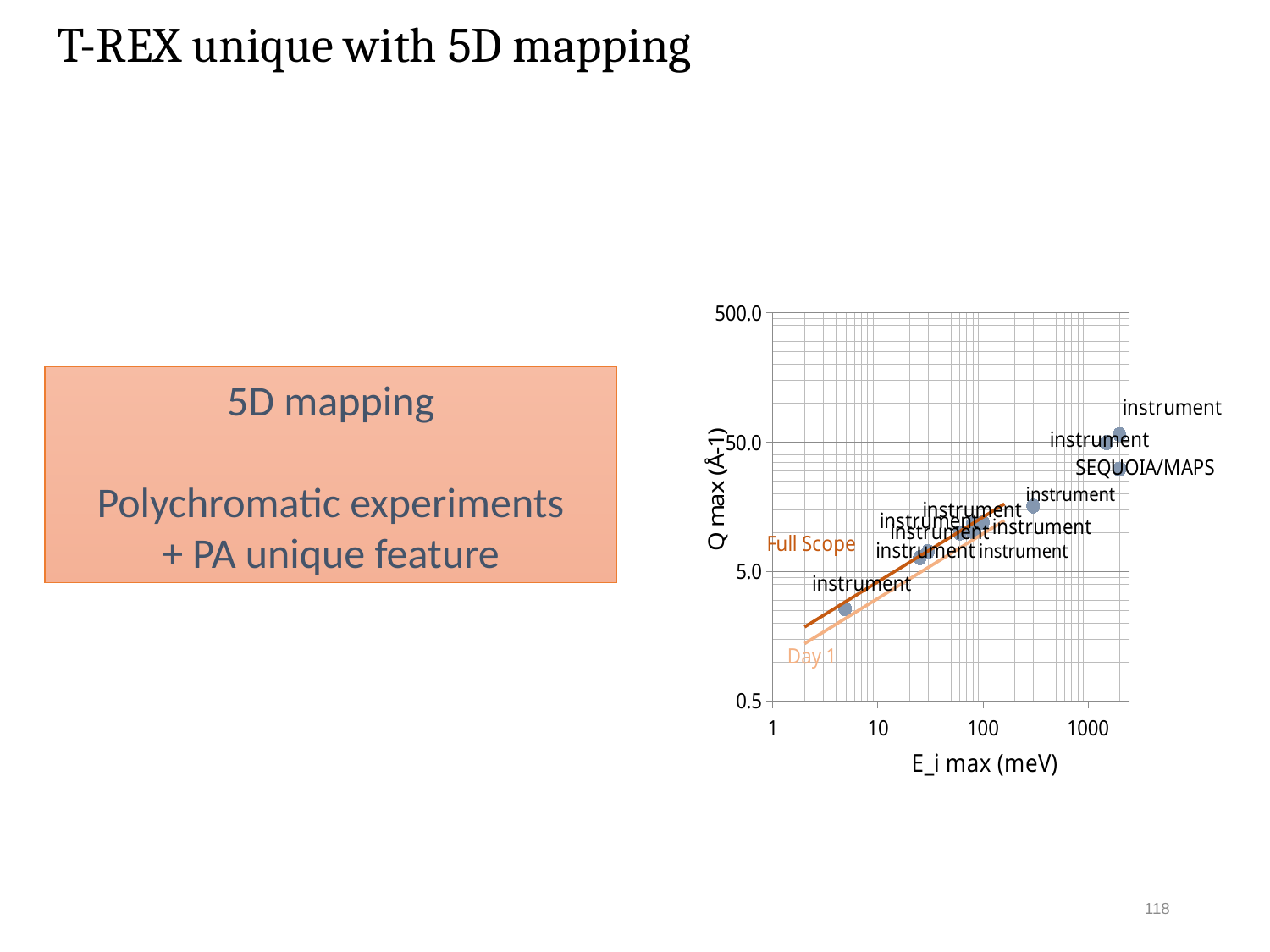
Is the Q max value for SEQUOIA/MAPS greater or less than 50.0? less What is the highest value shown on the y axis of the chart? 500.0 Which of the two lines lies higher on the chart, Full Scope or Day 1? Full Scope Is the E_i max value for SEQUOIA/MAPS greater or less than 100? greater Is the E_i max value of the leftmost instrument point greater or less than 10? less What is the label of the y axis of the chart? Q max (Å-1) What is the label of the x axis of the chart? E_i max (meV) Which point has a higher Q max, SEQUOIA/MAPS or the leftmost instrument point? SEQUOIA/MAPS What kind of chart is shown on the slide? scatter chart Does Q max rise or fall as E_i max increases along the x axis? rise